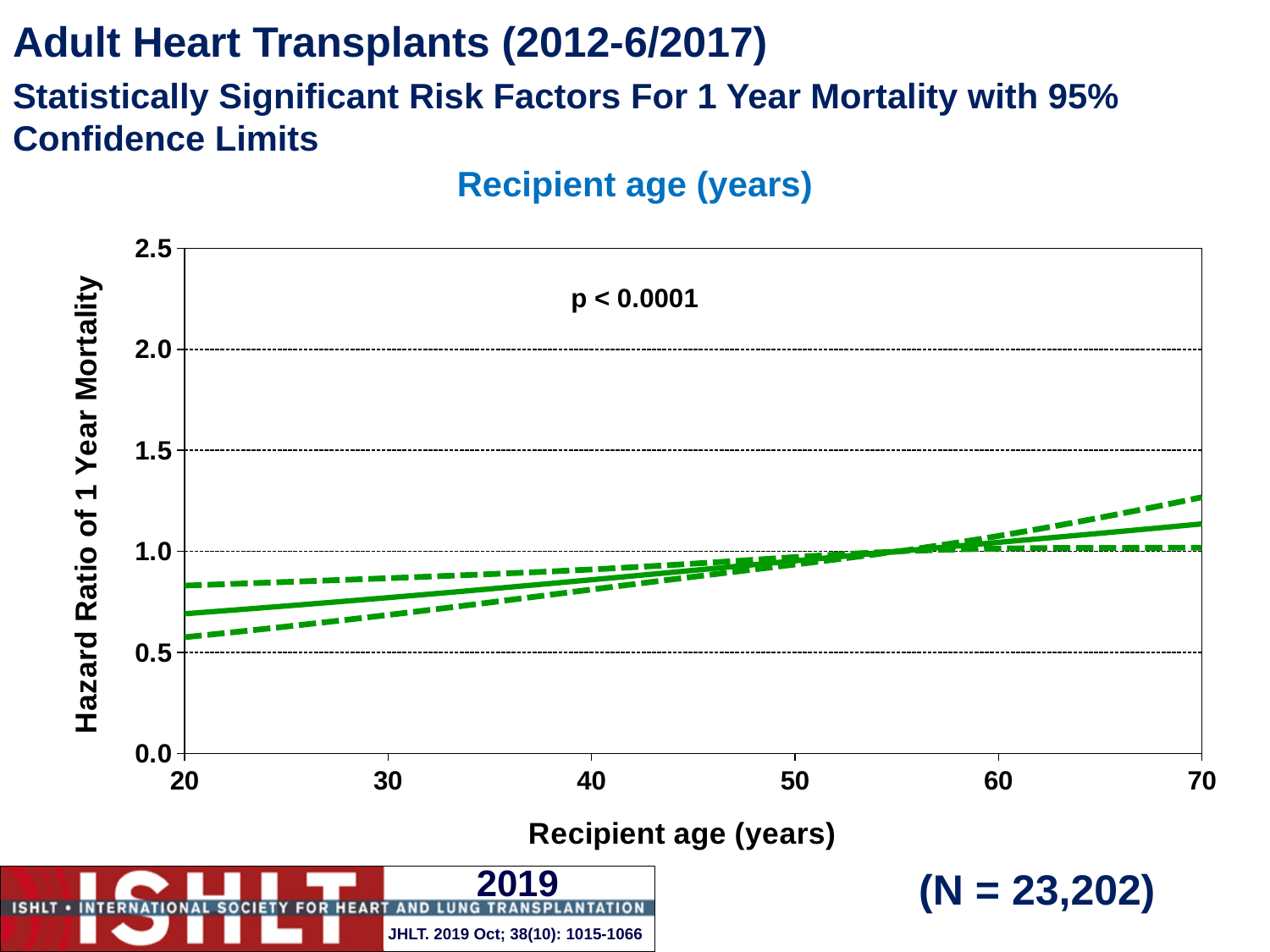
Is the hazard ratio (solid line) at recipient age 70 greater or less than 1.0? greater Is the upper 95% confidence limit at recipient age 70 greater or less than 1.5? less What p-value is printed on the chart? p < 0.0001 Is the hazard ratio (solid line) at recipient age 40 greater or less than 1.0? less What kind of chart is shown on the slide? line chart Does the hazard ratio of 1 year mortality rise or fall as recipient age increases from 20 to 70 years? rise What is the label of the y axis? Hazard Ratio of 1 Year Mortality Which is larger, the hazard ratio (solid line) at recipient age 30 or at recipient age 60? recipient age 60 How many lines are plotted on the chart? 3